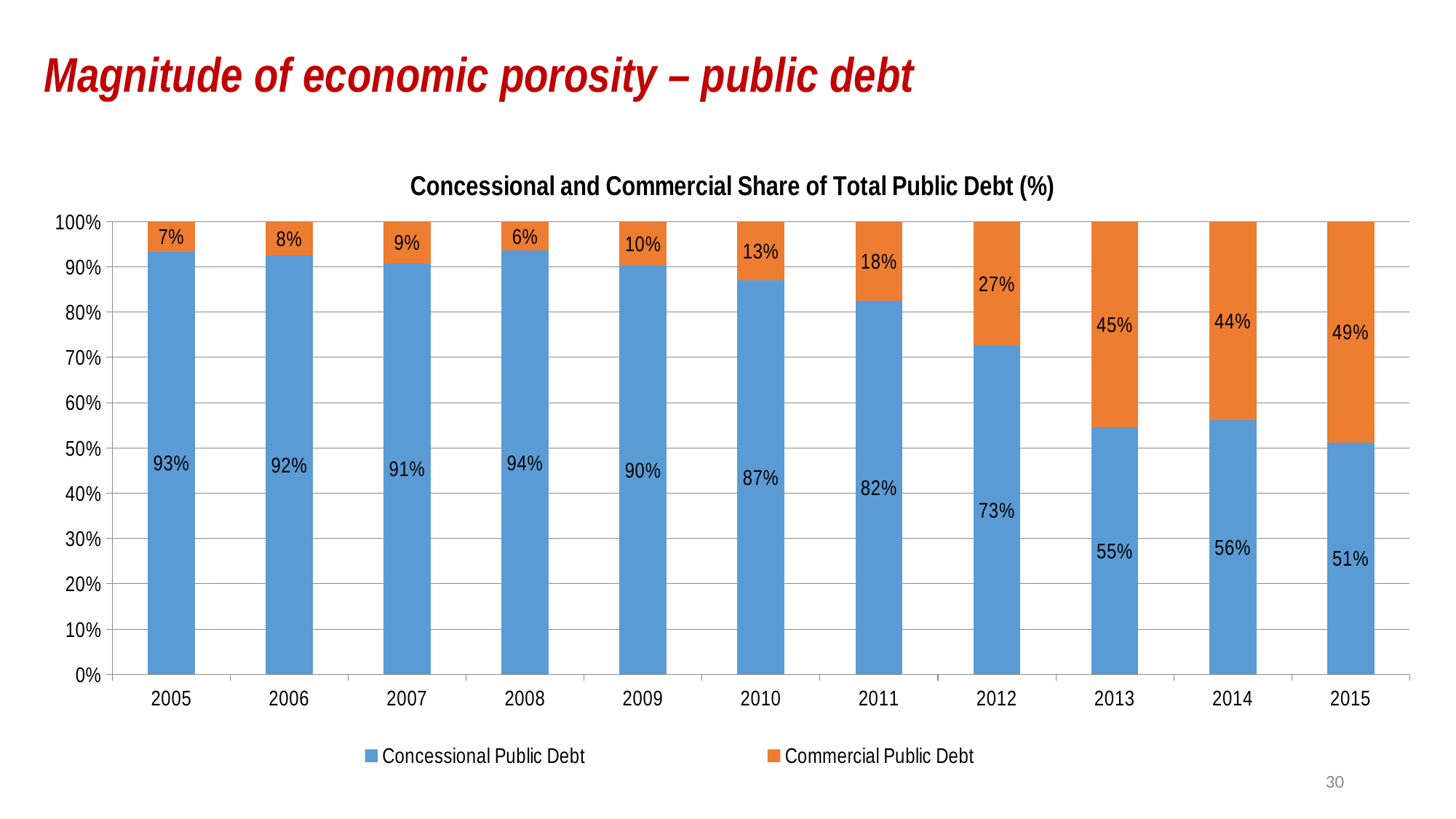
Does the Commercial Public Debt share generally rise or fall from 2008 to 2015? Rise What is the difference between the Concessional Public Debt share in 2005 and in 2015? 42 percentage points In which year is the Commercial Public Debt share lowest? 2008 What is the Commercial Public Debt share in 2010? 13% In which year is the Concessional Public Debt share highest? 2008 How many years are shown on the x axis? 11 In which year is the Commercial Public Debt share highest? 2015 Which is larger, the Commercial Public Debt share in 2013 or in 2014? 2013 What is the Concessional Public Debt share in 2012? 73% What is the Commercial Public Debt share in 2015? 49% What kind of chart is shown? Stacked bar chart How many series does the legend list? 2